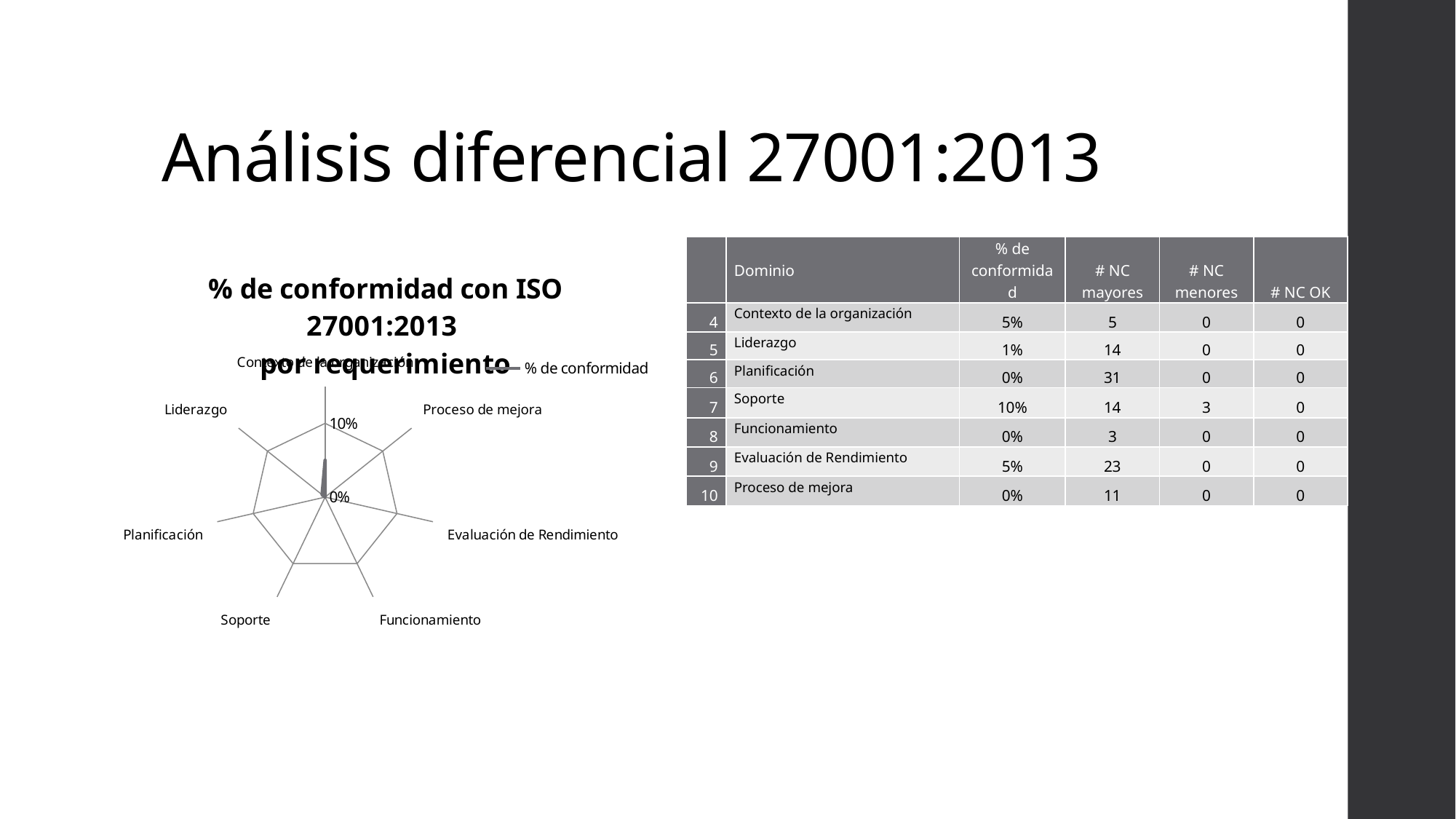
How many series does the legend of the radar chart list? 1 On the radar chart, is the value for Proceso de mejora greater or less than 10%? less On the radar chart, is the value for Funcionamiento greater or less than 10%? less What kind of chart is shown on the slide? radar chart How many categories (requirements) are plotted on the radar chart? 7 On the radar chart, is the value for Evaluación de Rendimiento greater or less than 10%? less What is the title of the radar chart? % de conformidad con ISO 27001:2013 por requerimiento What is the legend entry of the radar chart? % de conformidad